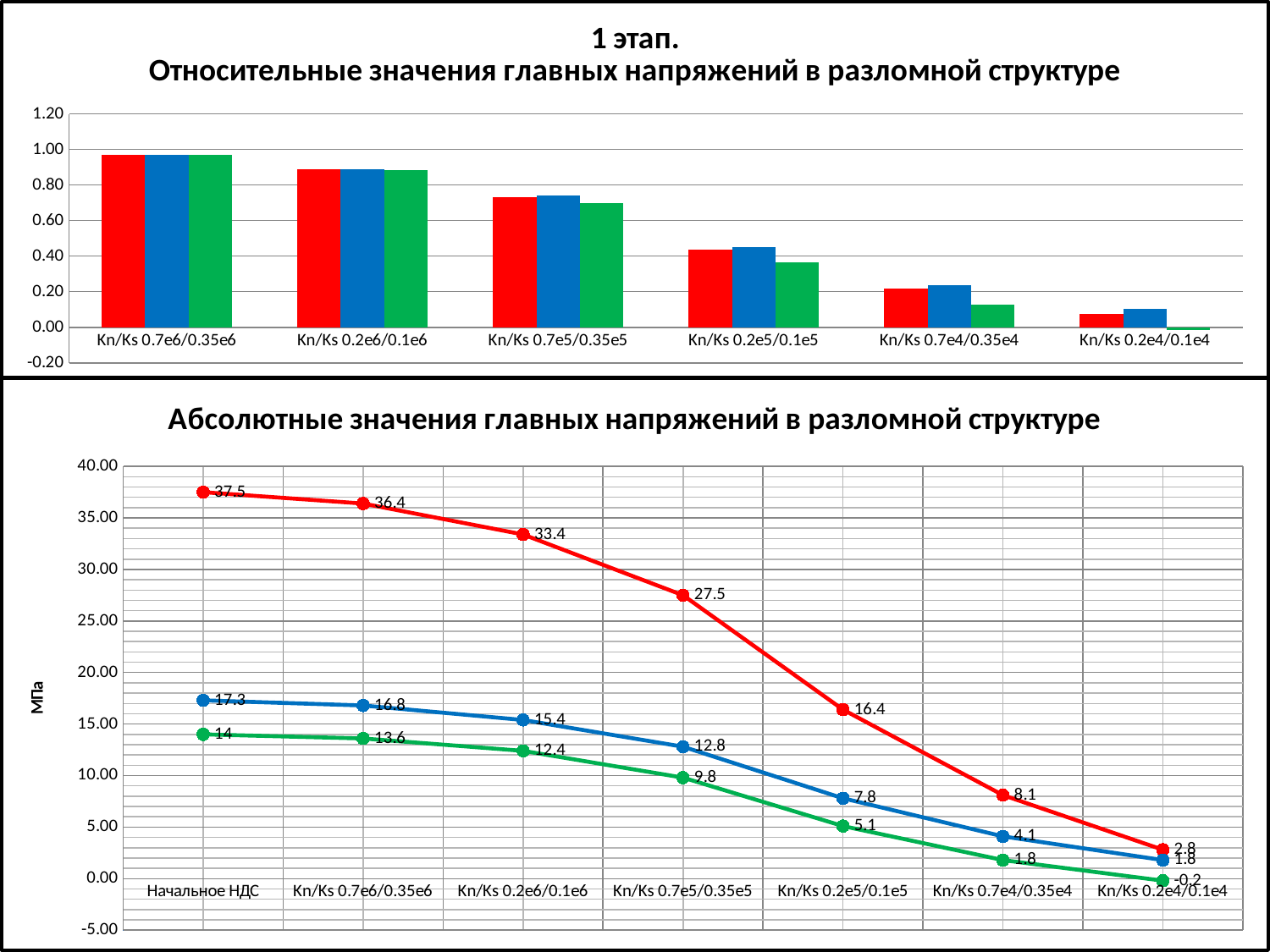
In the bottom chart, how many categories are shown on the x axis? 7 In the bottom chart, does the red line rise or fall from left to right along the x axis? fall In the bottom chart, what is the value of the green line at Kn/Ks 0.2e4/0.1e4? -0.2 In the top chart, is the green bar for Kn/Ks 0.2e5/0.1e5 greater or less than 0.40? less In the top chart, is the red bar for Kn/Ks 0.7e6/0.35e6 greater or less than 0.80? greater What kind of chart is the bottom chart, "Абсолютные значения главных напряжений в разломной структуре"? line chart In the bottom chart, what is the difference between the red line and the green line at Начальное НДС? 23.5 What kind of chart is the top chart, "1 этап. Относительные значения главных напряжений в разломной структуре"? bar chart In the bottom chart, what is the value of the red line at Начальное НДС? 37.5 In the top chart, how many categories are shown on the x axis? 6 In the bottom chart, what is the value of the blue line at Kn/Ks 0.2e5/0.1e5? 7.8 In the bottom chart, what is the label on the vertical axis? МПа